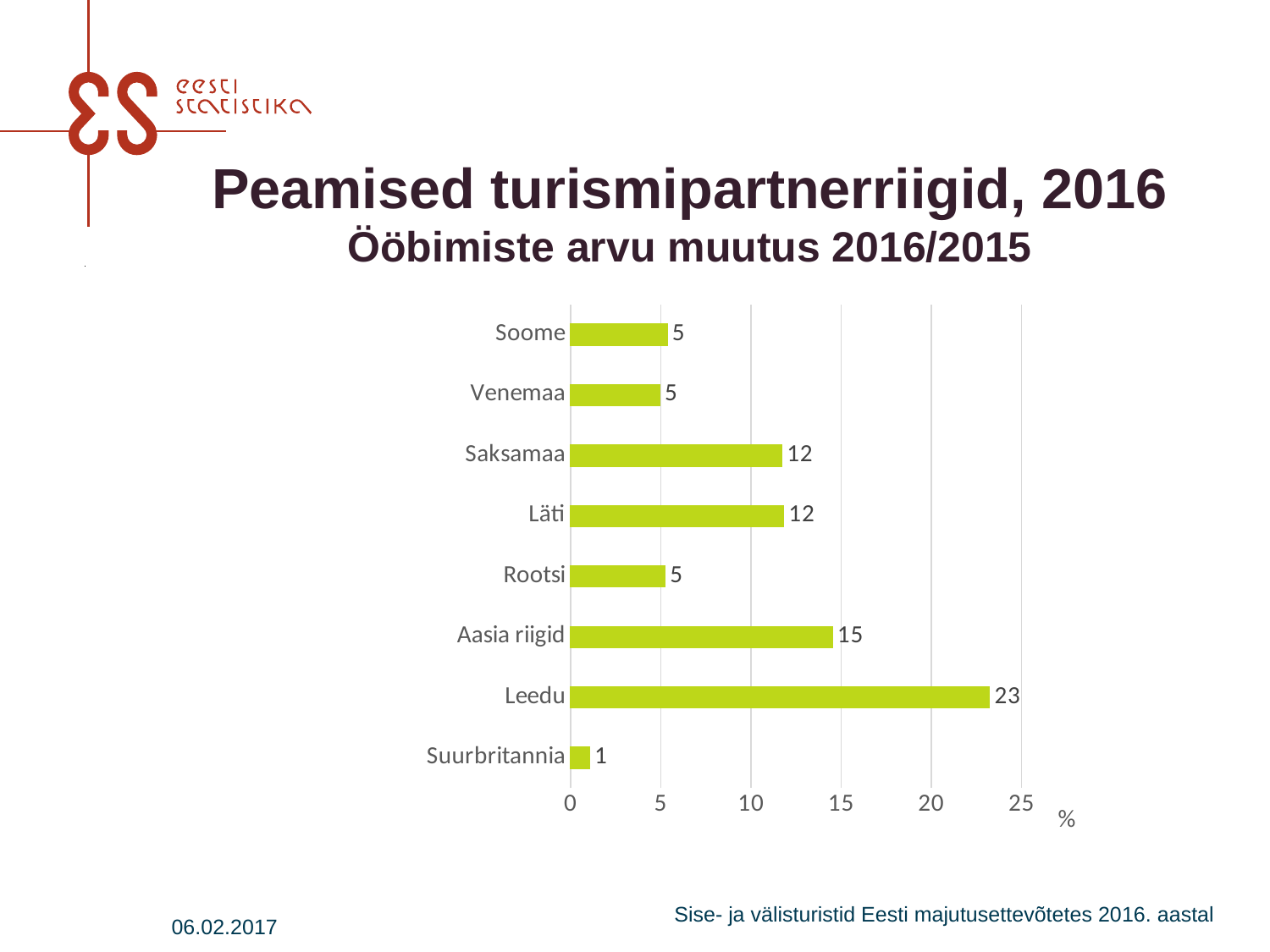
Which category has the lowest value? Suurbritannia What kind of chart is shown on the slide? bar chart Which category has the highest value? Leedu What is the value for Saksamaa? 12 What is the value for Suurbritannia? 1 What unit is shown at the end of the x axis? % How many categories are shown in the chart? 8 Is the value for Aasia riigid greater or less than 10? greater What is the value for Aasia riigid? 15 What is the difference between the values for Leedu and Aasia riigid? 8 What is the value for Leedu? 23 Which is larger, the value for Läti or the value for Rootsi? Läti